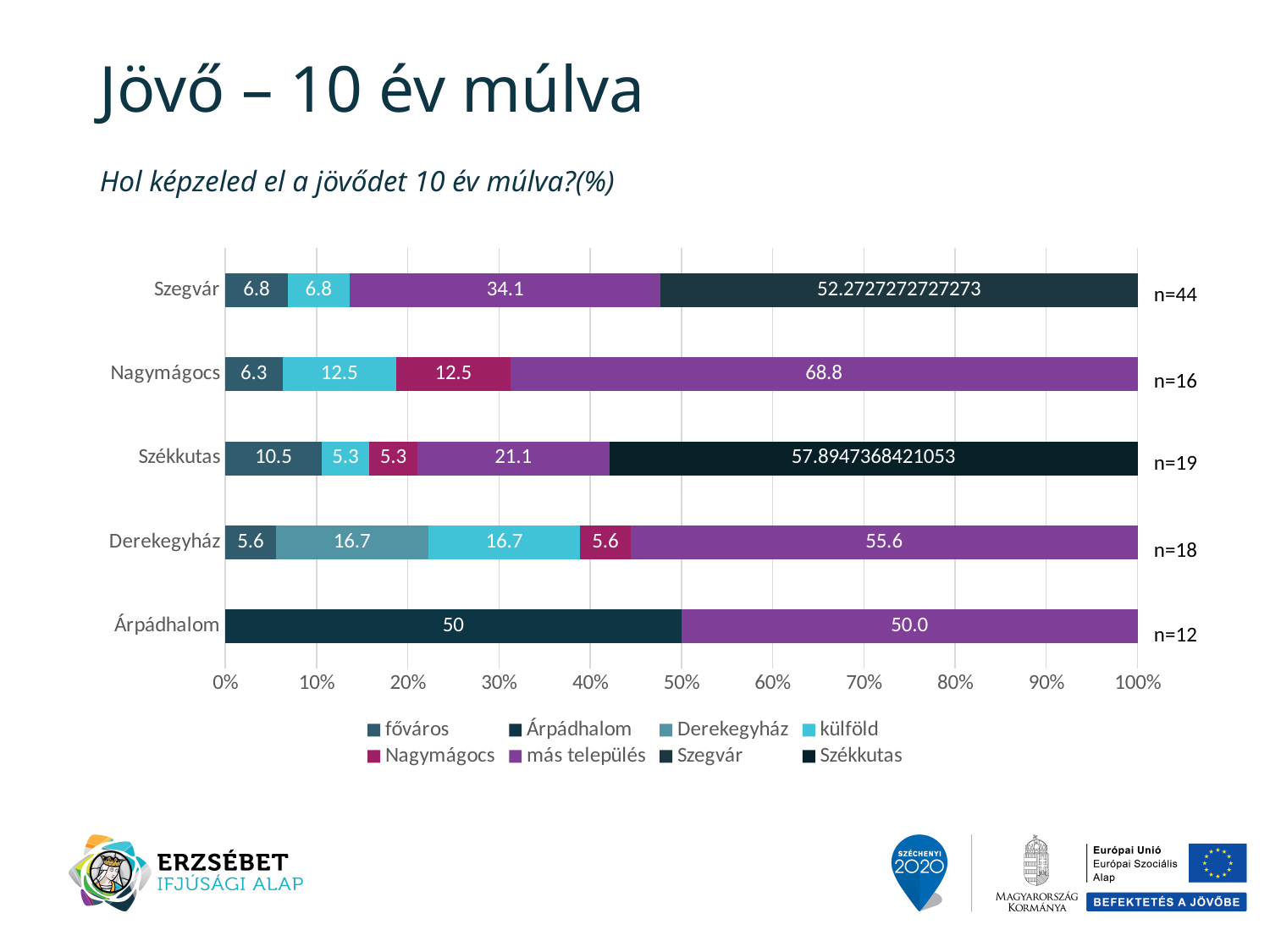
What is the value of the 'Szegvár' segment in the Szegvár bar? 52.2727272727273 What is the value of the 'más település' segment for Árpádhalom? 50.0 What is the value of the 'Derekegyház' segment for Derekegyház? 16.7 What is the difference between the 'más település' values for Nagymágocs and Szegvár? 34.7 How many categories (settlements) are shown on the vertical axis of the chart? 5 Which settlement has the highest 'más település' value? Nagymágocs What is the value of the 'főváros' segment for Székkutas? 10.5 Which settlement has the lowest 'főváros' value? Derekegyház What type of chart is shown on the slide? stacked bar chart How many series does the chart legend list? 8 What is the value of the 'más település' segment for Nagymágocs? 68.8 What is the sample size (n) shown for Szegvár? n=44